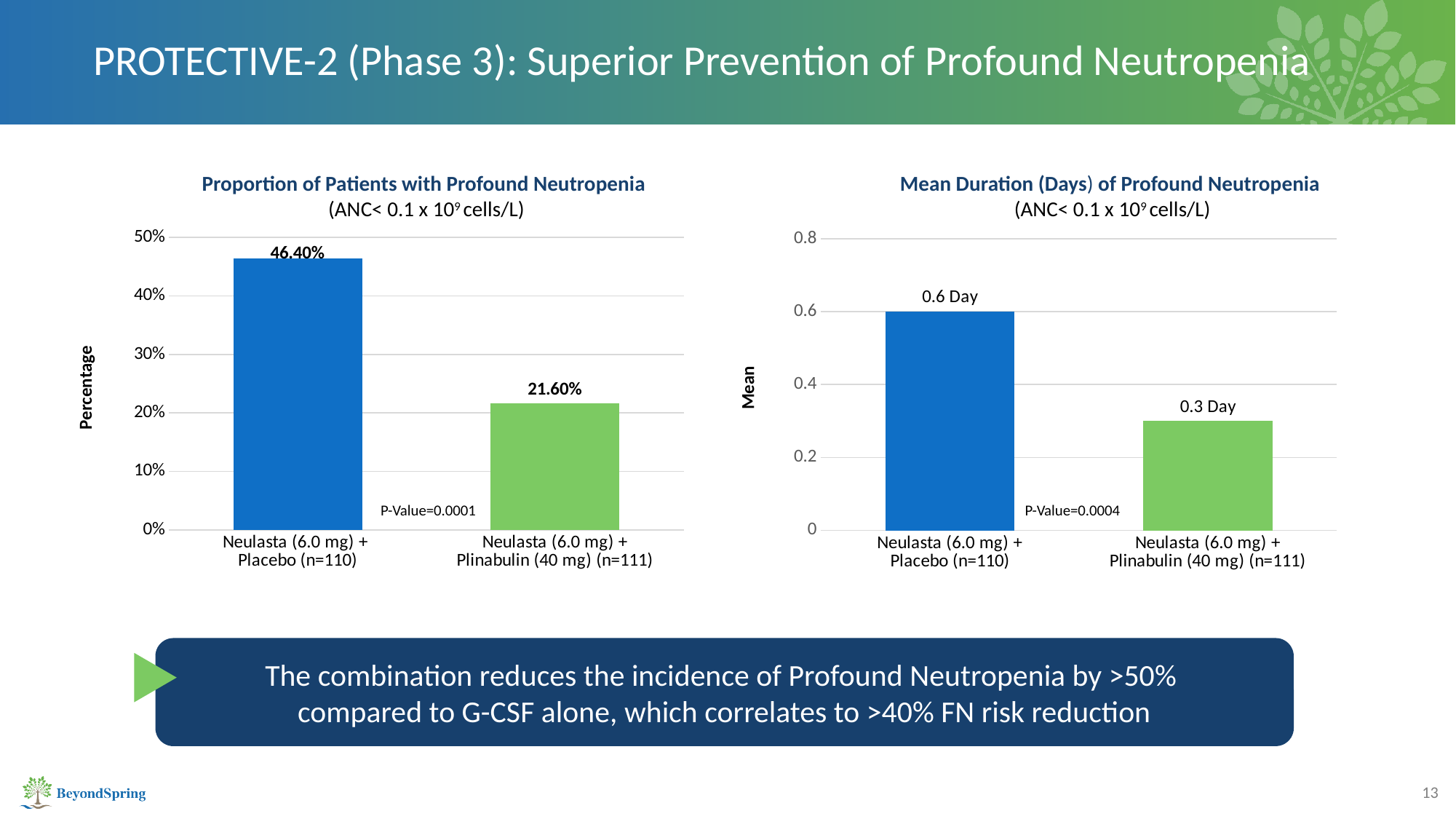
How many bars are shown in the 'Mean Duration (Days) of Profound Neutropenia' chart? 2 In the 'Mean Duration (Days) of Profound Neutropenia' chart, which group has the lowest value? Neulasta (6.0 mg) + Plinabulin (40 mg) (n=111) In the 'Mean Duration (Days) of Profound Neutropenia' chart, what is the difference between the Placebo group and the Plinabulin group? 0.3 Day In the 'Proportion of Patients with Profound Neutropenia' chart, what is the value for Neulasta (6.0 mg) + Plinabulin (40 mg) (n=111)? 21.60% In the 'Proportion of Patients with Profound Neutropenia' chart, is the value for Neulasta (6.0 mg) + Plinabulin (40 mg) (n=111) greater or less than 30%? less In the 'Proportion of Patients with Profound Neutropenia' chart, what is the difference between the Placebo group and the Plinabulin group? 24.80% In the 'Proportion of Patients with Profound Neutropenia' chart, what is the value for Neulasta (6.0 mg) + Placebo (n=110)? 46.40% What P-Value is printed on the 'Mean Duration (Days) of Profound Neutropenia' chart? P-Value=0.0004 In the 'Mean Duration (Days) of Profound Neutropenia' chart, what is the value for Neulasta (6.0 mg) + Plinabulin (40 mg) (n=111)? 0.3 Day What kind of chart is the 'Proportion of Patients with Profound Neutropenia' chart? bar chart In the 'Proportion of Patients with Profound Neutropenia' chart, which group has the highest value? Neulasta (6.0 mg) + Placebo (n=110) In the 'Mean Duration (Days) of Profound Neutropenia' chart, what is the value for Neulasta (6.0 mg) + Placebo (n=110)? 0.6 Day